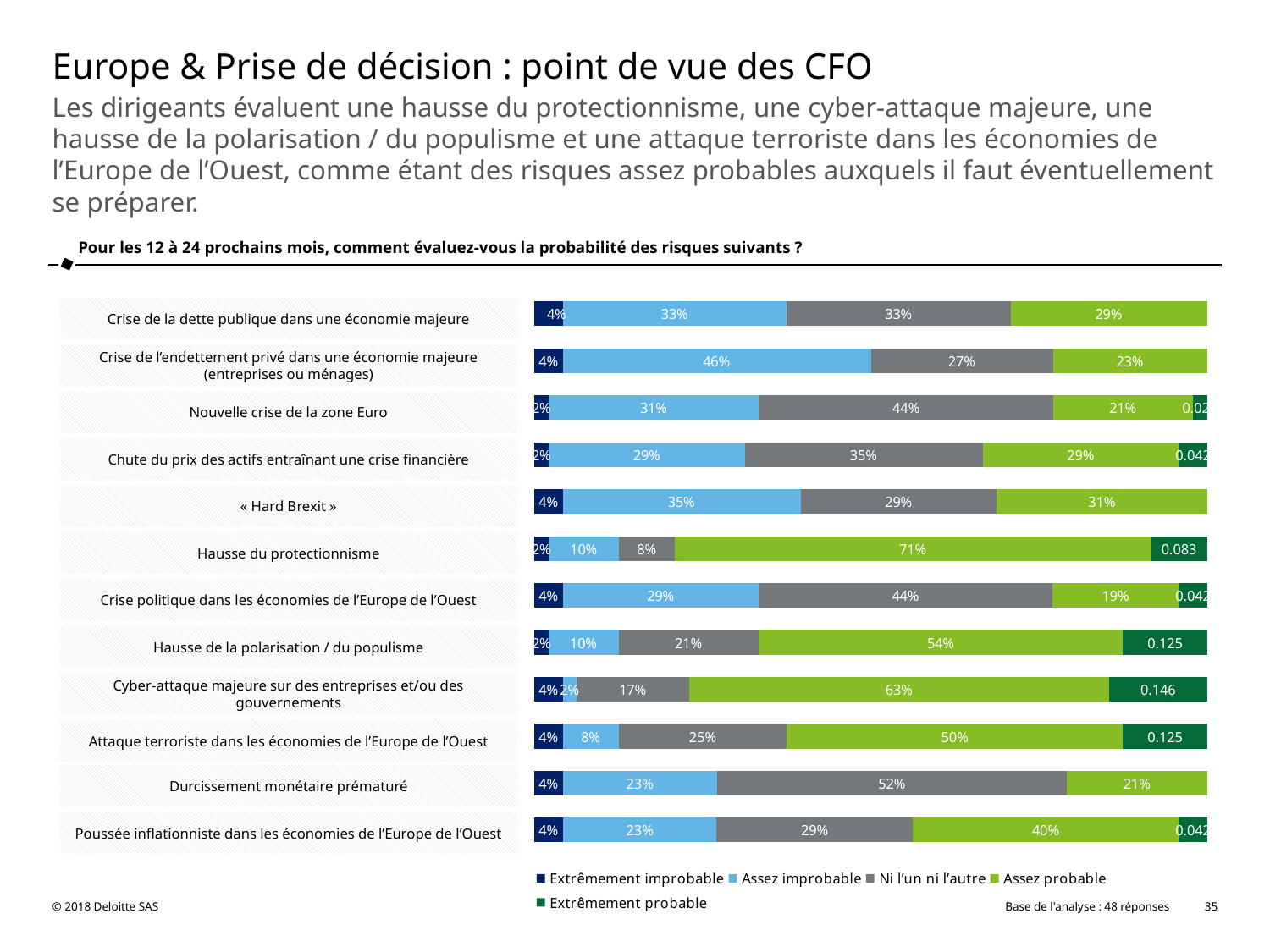
Which is larger: the "Ni l'un ni l'autre" value for "Nouvelle crise de la zone Euro" or for "Chute du prix des actifs entraînant une crise financière"? Nouvelle crise de la zone Euro How many risk categories are shown in the chart? 12 What type of chart is shown on the slide? Stacked bar chart Which risk has the lowest "Assez probable" value? Crise politique dans les économies de l'Europe de l'Ouest What is the difference between the "Assez probable" values for "Hausse de la polarisation / du populisme" and "Attaque terroriste dans les économies de l'Europe de l'Ouest"? 4% What is the "Extrêmement probable" value shown for "Cyber-attaque majeure sur des entreprises et/ou des gouvernements"? 0.146 What is the "Ni l'un ni l'autre" value for "Durcissement monétaire prématuré"? 52% What is the "Assez improbable" value for "Crise de l'endettement privé dans une économie majeure (entreprises ou ménages)"? 46% Which legend entry is represented by the light green colour? Assez probable Which risk has the highest "Assez probable" value? Hausse du protectionnisme What percentage of respondents rated "Hausse du protectionnisme" as "Assez probable"? 71% How many series does the legend list? 5